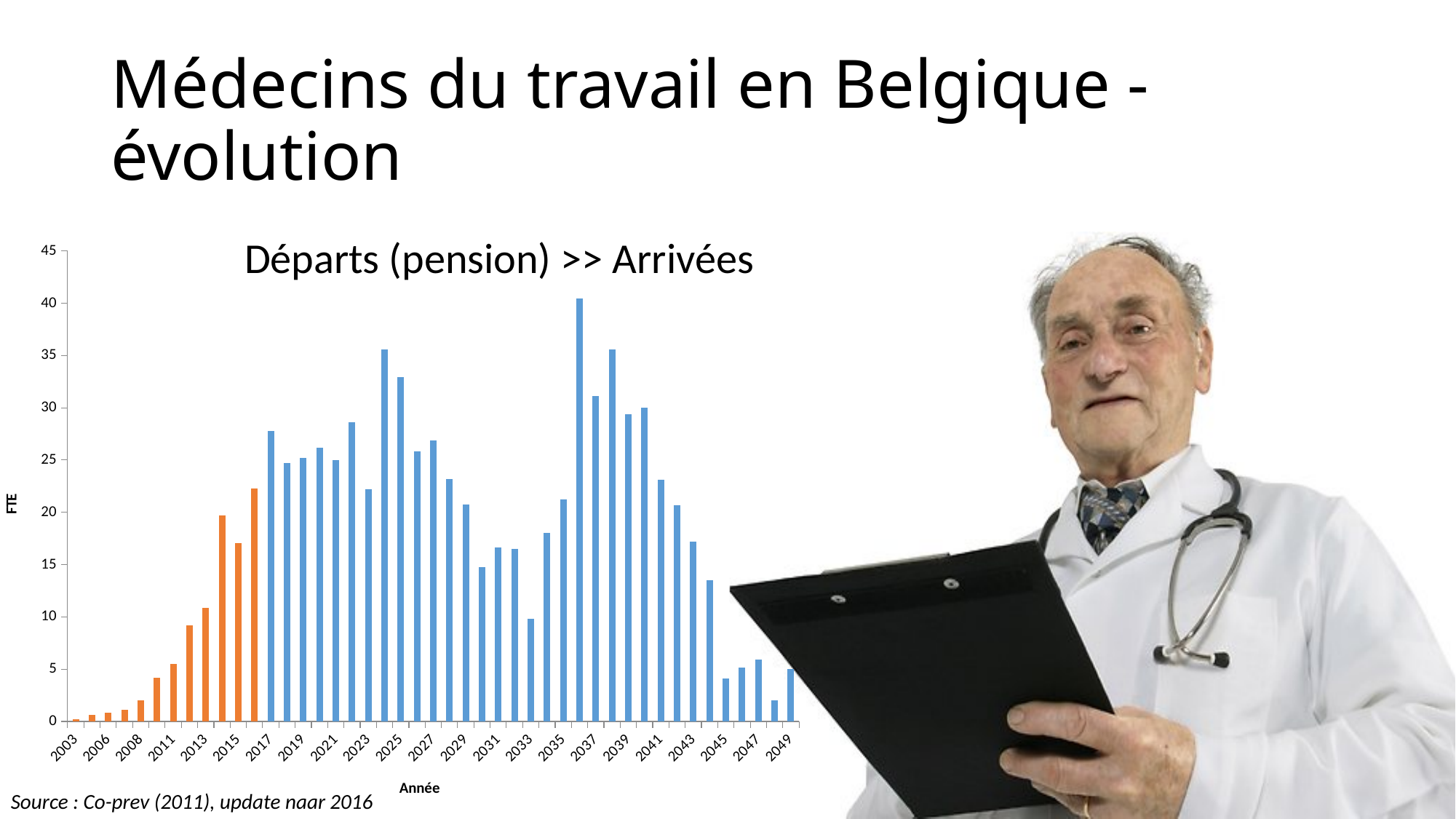
Is the value for 2033 greater or less than 15? less Which year has the highest value in the chart? 2036 What is the label on the vertical axis of the chart? FTE What type of chart is shown on the slide? Bar chart Do the values rise or fall from 2003 to 2017? rise Is the value for 2047 greater or less than 10? less Is the value for 2037 greater or less than 35? less Which is larger, the value for 2037 or the value for 2025? 2025 Which year has the lowest value in the chart? 2003 Which is larger, the value for 2033 or the value for 2035? 2035